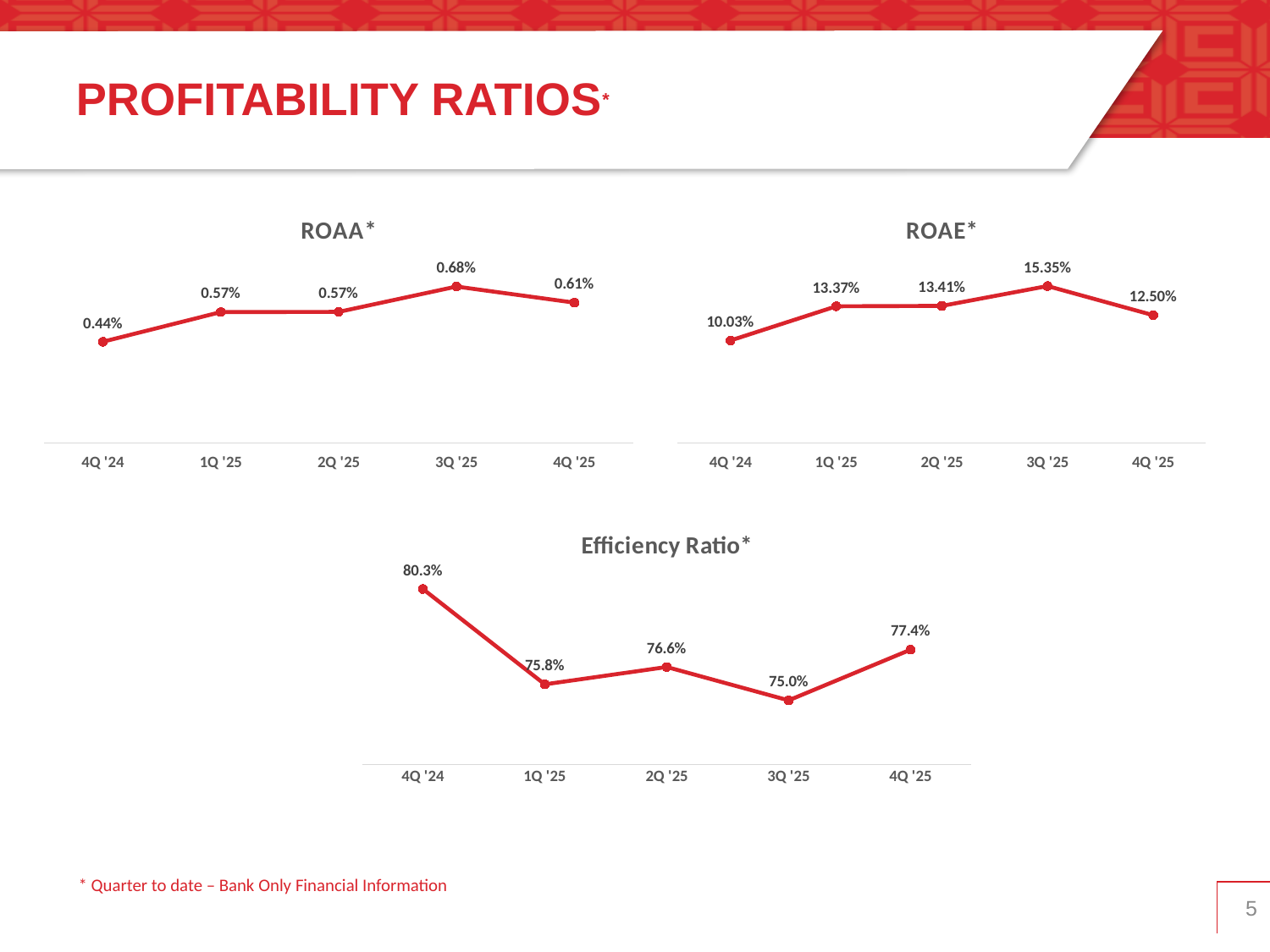
In the ROAA* chart, which quarter has the lowest value? 4Q '24 In the ROAA* chart, what is the value for 3Q '25? 0.68% In the Efficiency Ratio* chart, which is larger, the value for 2Q '25 or the value for 4Q '25? 4Q '25 In the ROAE* chart, what is the difference between the 3Q '25 and 4Q '24 values? 5.32% What type of chart is the Efficiency Ratio* chart? Line chart In the ROAA* chart, what is the difference between the 4Q '25 and 4Q '24 values? 0.17% In the Efficiency Ratio* chart, which quarter has the lowest value? 3Q '25 In the ROAE* chart, what is the value for 4Q '25? 12.50% In the Efficiency Ratio* chart, which quarter has the highest value? 4Q '24 How many quarters are plotted in the ROAE* chart? 5 In the ROAE* chart, which quarter has the highest value? 3Q '25 In the Efficiency Ratio* chart, what is the value for 1Q '25? 75.8%